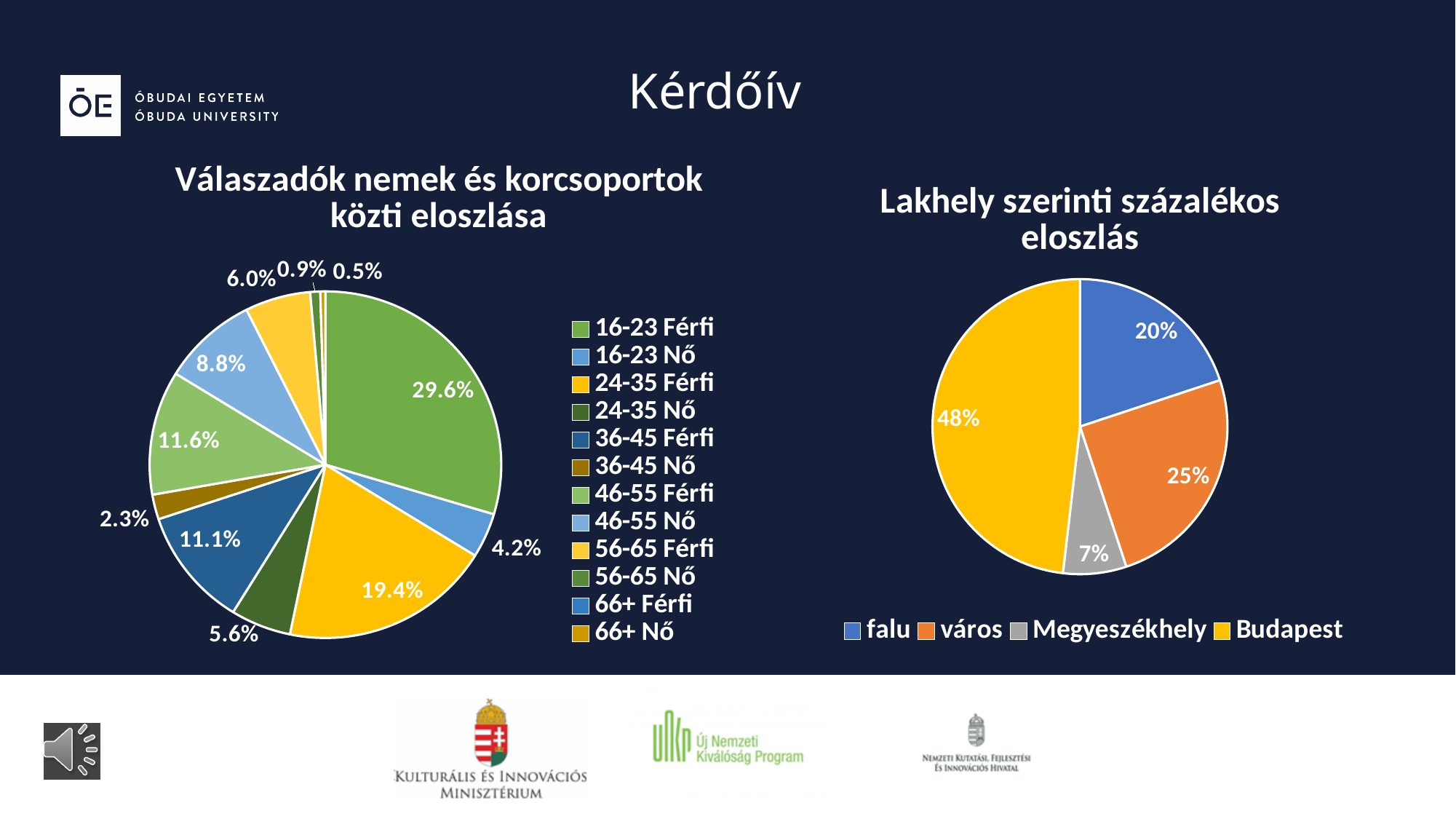
In the chart titled 'Lakhely szerinti százalékos eloszlás', which category has the smallest share? Megyeszékhely In the chart titled 'Válaszadók nemek és korcsoportok közti eloszlása', what is the difference between the values for 16-23 Férfi and 16-23 Nő? 25.4% In the chart titled 'Lakhely szerinti százalékos eloszlás', which category has the largest share? Budapest In the chart titled 'Válaszadók nemek és korcsoportok közti eloszlása', what is the value for 36-45 Nő? 2.3% In the chart titled 'Válaszadók nemek és korcsoportok közti eloszlása', what is the value for 16-23 Férfi? 29.6% In the chart titled 'Lakhely szerinti százalékos eloszlás', what share does Budapest have? 48% What kind of chart is the chart titled 'Lakhely szerinti százalékos eloszlás'? pie chart In the chart titled 'Válaszadók nemek és korcsoportok közti eloszlása', how many categories does the legend list? 12 In the chart titled 'Lakhely szerinti százalékos eloszlás', what is the difference between the shares of város and falu? 5% In the chart titled 'Lakhely szerinti százalékos eloszlás', how many categories does the legend list? 4 In the chart titled 'Válaszadók nemek és korcsoportok közti eloszlása', which category has the largest share? 16-23 Férfi In the chart titled 'Válaszadók nemek és korcsoportok közti eloszlása', what is the value for 24-35 Férfi? 19.4%